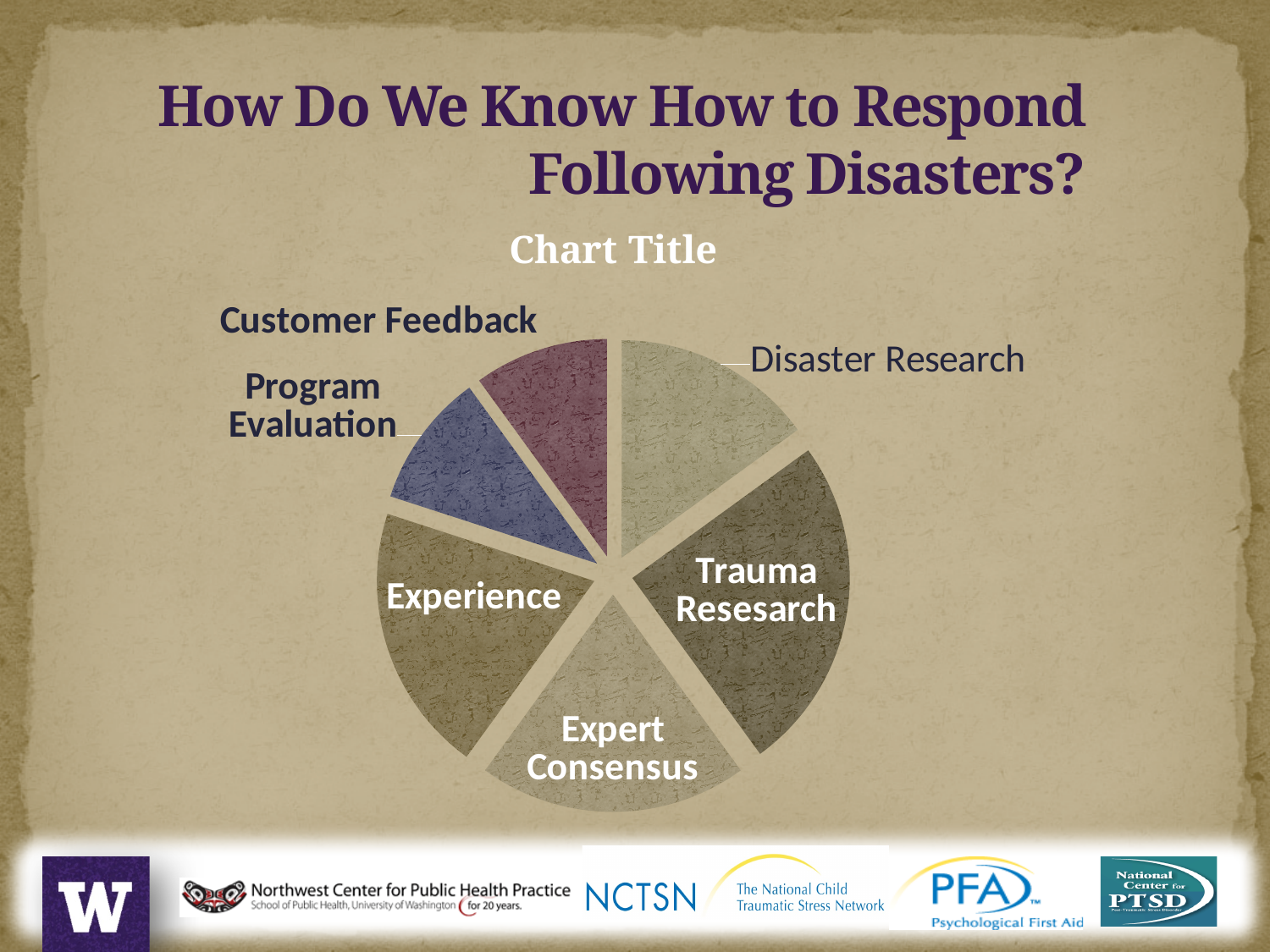
What is the title shown above the pie chart? Chart Title Which slice is larger, Experience or Customer Feedback? Experience Which slice is larger, Expert Consensus or Program Evaluation? Expert Consensus Which slice of the pie chart is the largest? Trauma Research What kind of chart is shown on the slide? pie chart How many slices does the pie chart have? 6 Which slice is larger, Trauma Research or Program Evaluation? Trauma Research Which slice of the pie chart is labelled with a purple-red colour? Customer Feedback